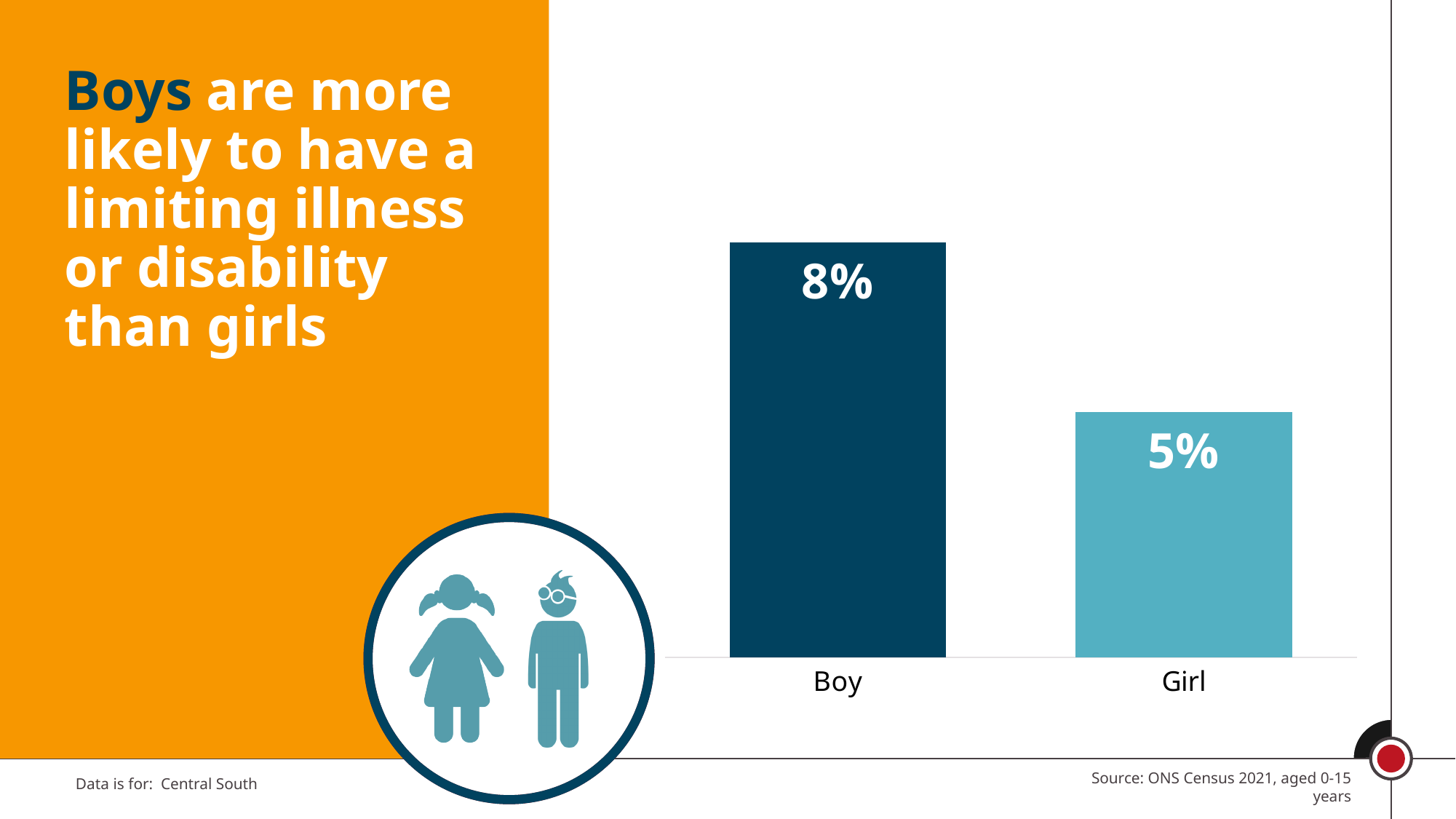
Which area is the data on the slide for? Central South Which category has the highest value? Boy What is the value for Girl? 5% How many categories are shown in the chart? 2 Which category has the lowest value? Girl Which is larger, the value for Boy or the value for Girl? Boy What kind of chart is shown on the slide? Bar chart What is the value for Boy? 8% Do the values rise or fall from Boy to Girl along the x axis? Fall What is the source of the data shown in the chart? ONS Census 2021, aged 0-15 years What is the difference between the values for Boy and Girl? 3%